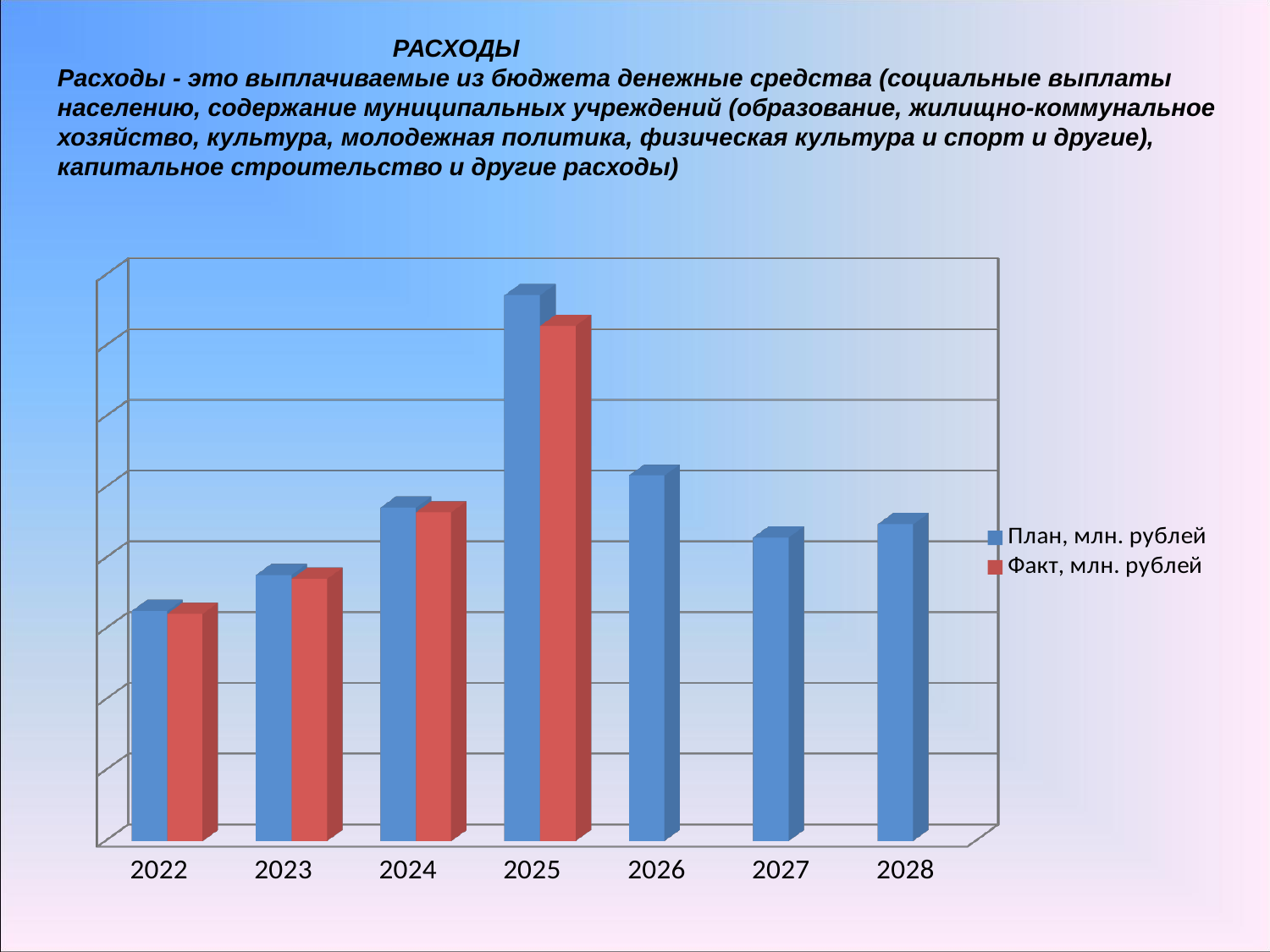
How many years are shown on the x axis of the chart? 7 For how many years does the chart show a bar for 'Факт, млн. рублей'? 4 Do the values of 'План, млн. рублей' rise or fall from 2022 to 2025? rise What kind of chart is shown on the slide? bar chart In 2025, which is larger: 'План, млн. рублей' or 'Факт, млн. рублей'? План, млн. рублей For the series 'План, млн. рублей', which year has the larger value: 2026 or 2027? 2026 How many series does the chart legend list? 2 Which year has the highest value for the series 'План, млн. рублей'? 2025 Which year has the lowest value for the series 'Факт, млн. рублей'? 2022 Which year has the highest value for the series 'Факт, млн. рублей'? 2025 Which year has the lowest value for the series 'План, млн. рублей'? 2022 What colour are the bars for the series 'Факт, млн. рублей'? red